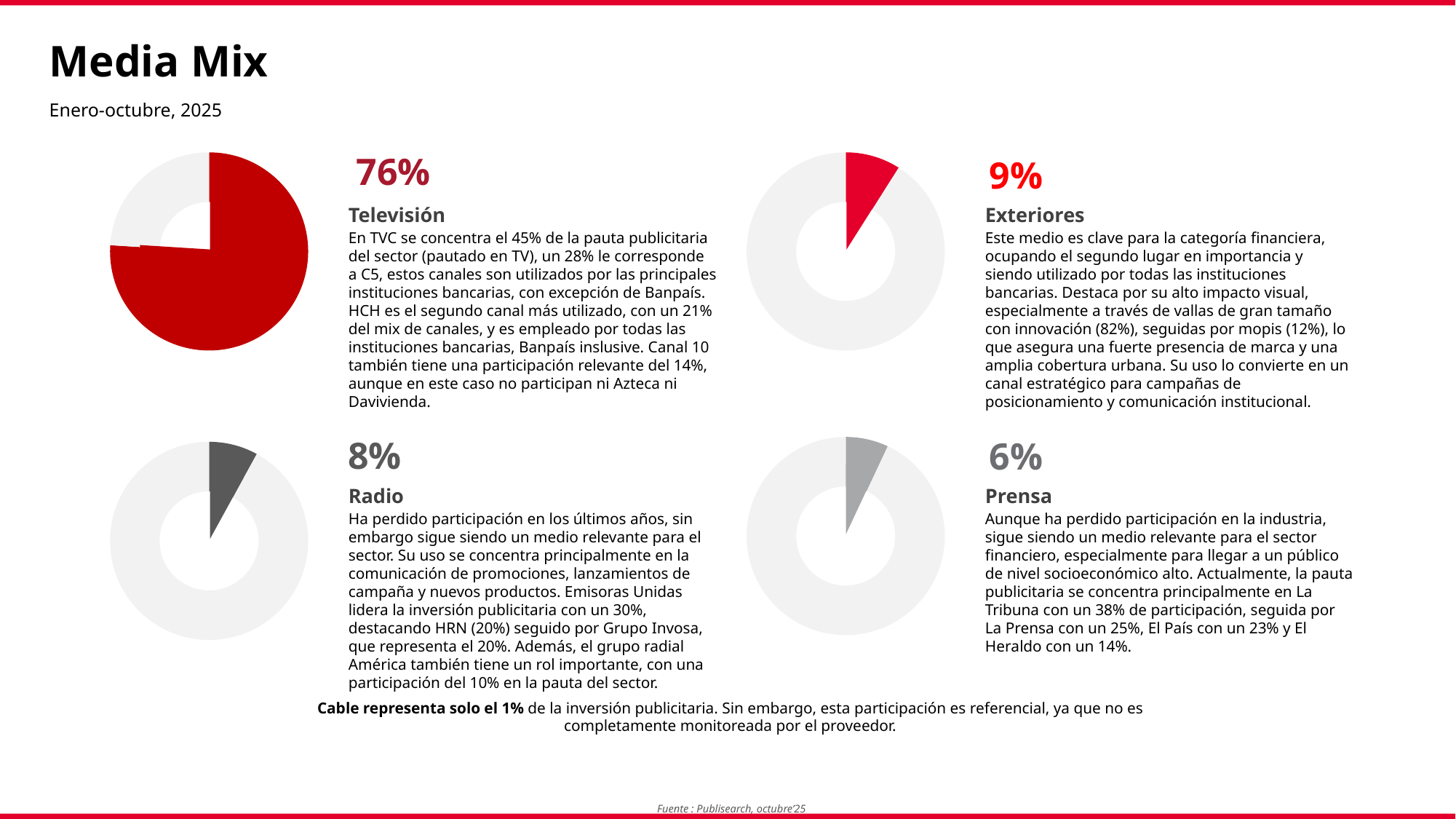
Which medium has the smallest share among the four donut charts on the slide? Prensa How many donut charts are shown on the slide? 4 What share of the media mix does the Prensa donut chart show? 6% What share of the media mix does the Televisión donut chart show? 76% Which has a larger share, Exteriores or Radio? Exteriores What type of chart is used to show each medium's share on the slide? Donut (pie) chart Which medium has the largest share among the four donut charts on the slide? Televisión What share of the media mix does the Exteriores donut chart show? 9% What is the difference in percentage points between the Radio share and the Prensa share? 2 What share of the media mix does the Radio donut chart show? 8% What colour is the highlighted slice in the Televisión donut chart? Red What is the difference in percentage points between the Televisión share and the Exteriores share? 67